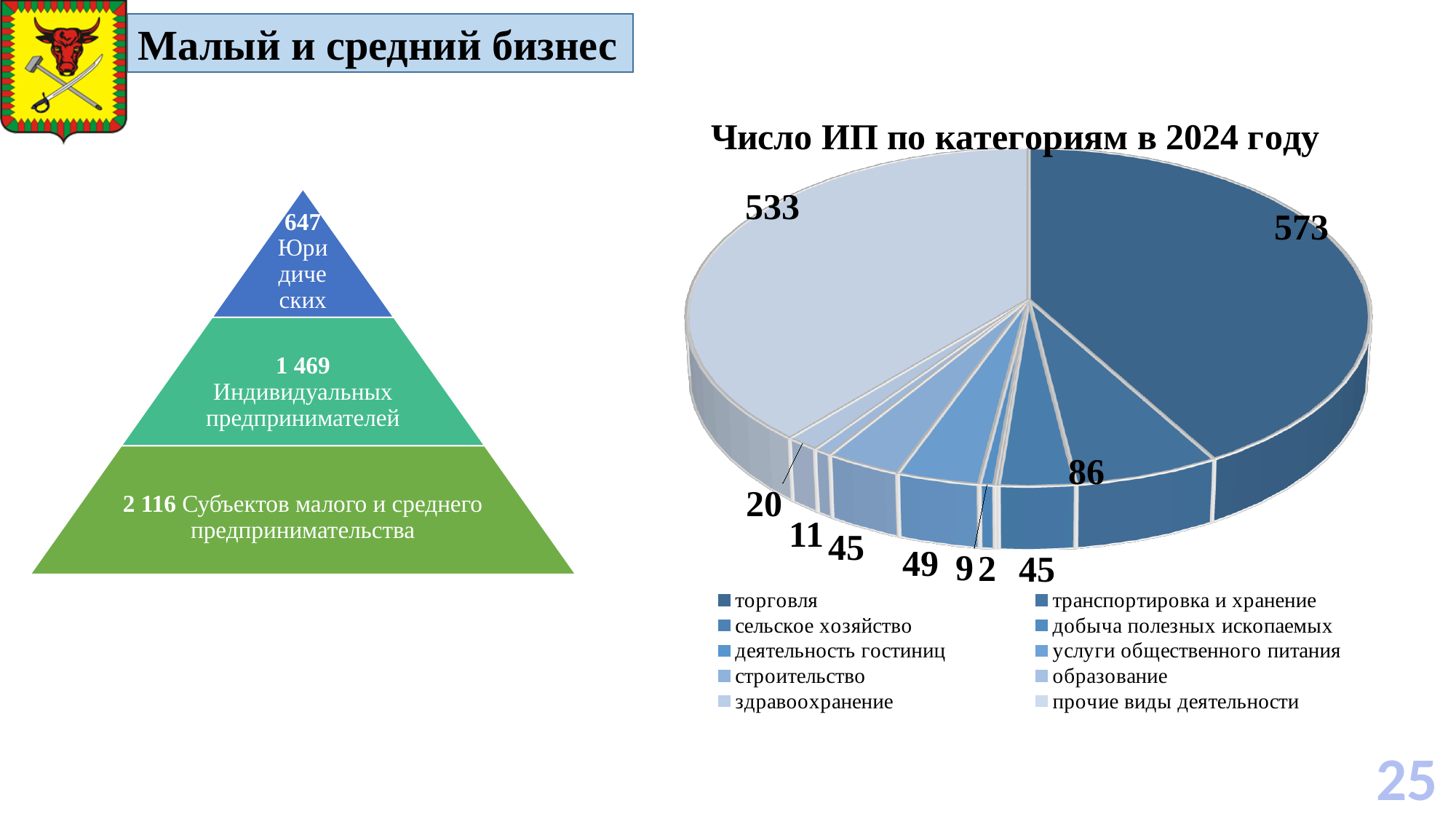
What is the difference between the values for торговля and прочие виды деятельности? 40 What is the value for здравоохранение? 20 Which is larger: транспортировка и хранение or услуги общественного питания? транспортировка и хранение What is the value for прочие виды деятельности? 533 What is the difference between the values for здравоохранение and образование? 9 What is the value for торговля? 573 Which category has the largest slice? торговля What is the value for транспортировка и хранение? 86 How many categories does the pie chart show? 10 What is the title of the chart? Число ИП по категориям в 2024 году What kind of chart is shown on the slide? pie chart Which category has the smallest slice? добыча полезных ископаемых